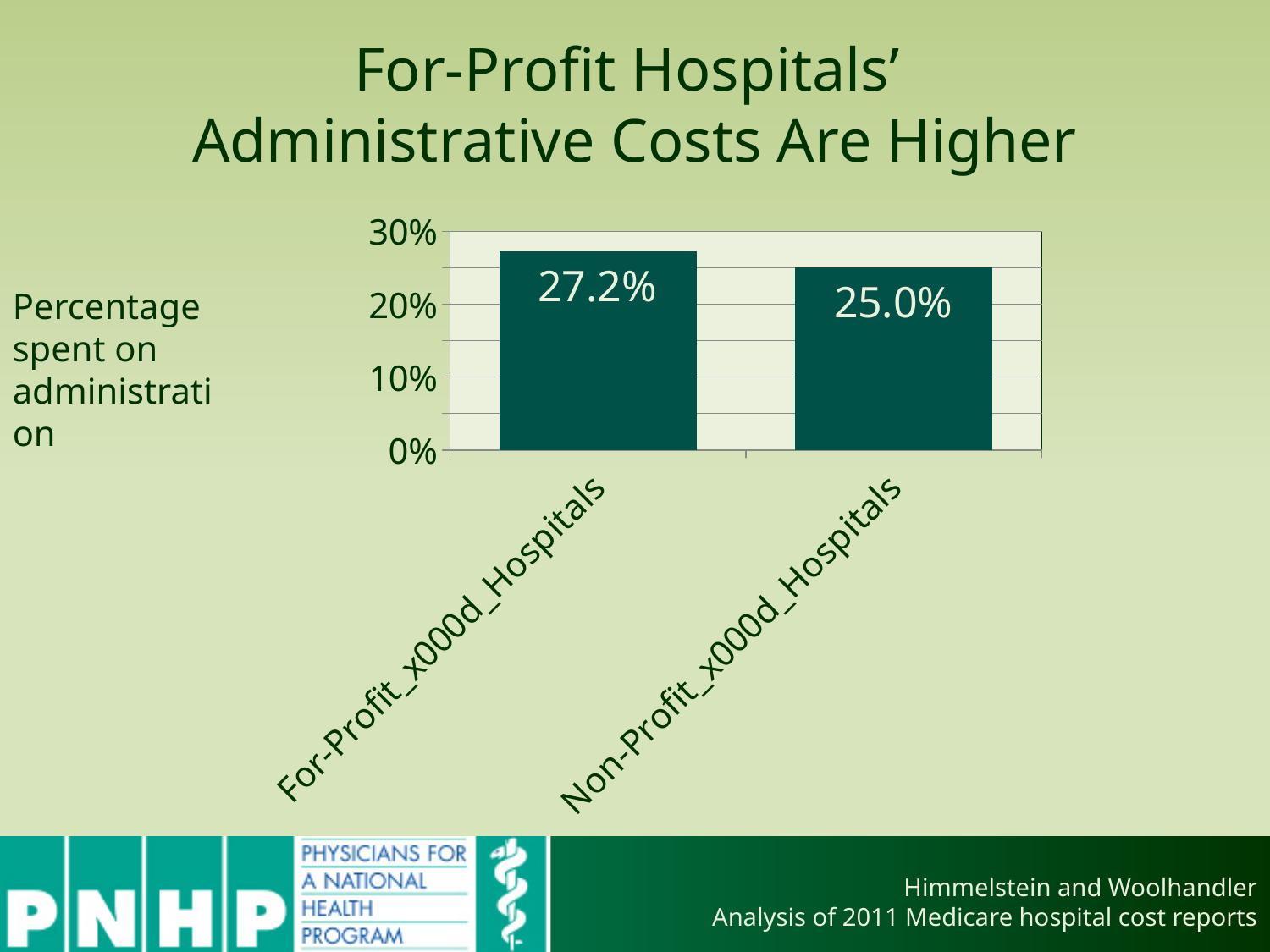
How many categories are plotted in the chart? 2 What is the title of the slide? For-Profit Hospitals' Administrative Costs Are Higher Which category has the lower percentage spent on administration? Non-Profit Hospitals What is the difference in percentage points between For-Profit Hospitals and Non-Profit Hospitals? 2.2 Is the value for Non-Profit Hospitals greater or less than 20%? greater Which category has the higher percentage spent on administration? For-Profit Hospitals Is the value for For-Profit Hospitals larger or smaller than the value for Non-Profit Hospitals? larger Is the value for For-Profit Hospitals greater or less than 30%? less What percentage is shown for For-Profit Hospitals? 27.2% What kind of chart is shown on the slide? bar chart What is the highest value shown on the vertical axis? 30% What percentage is shown for Non-Profit Hospitals? 25.0%